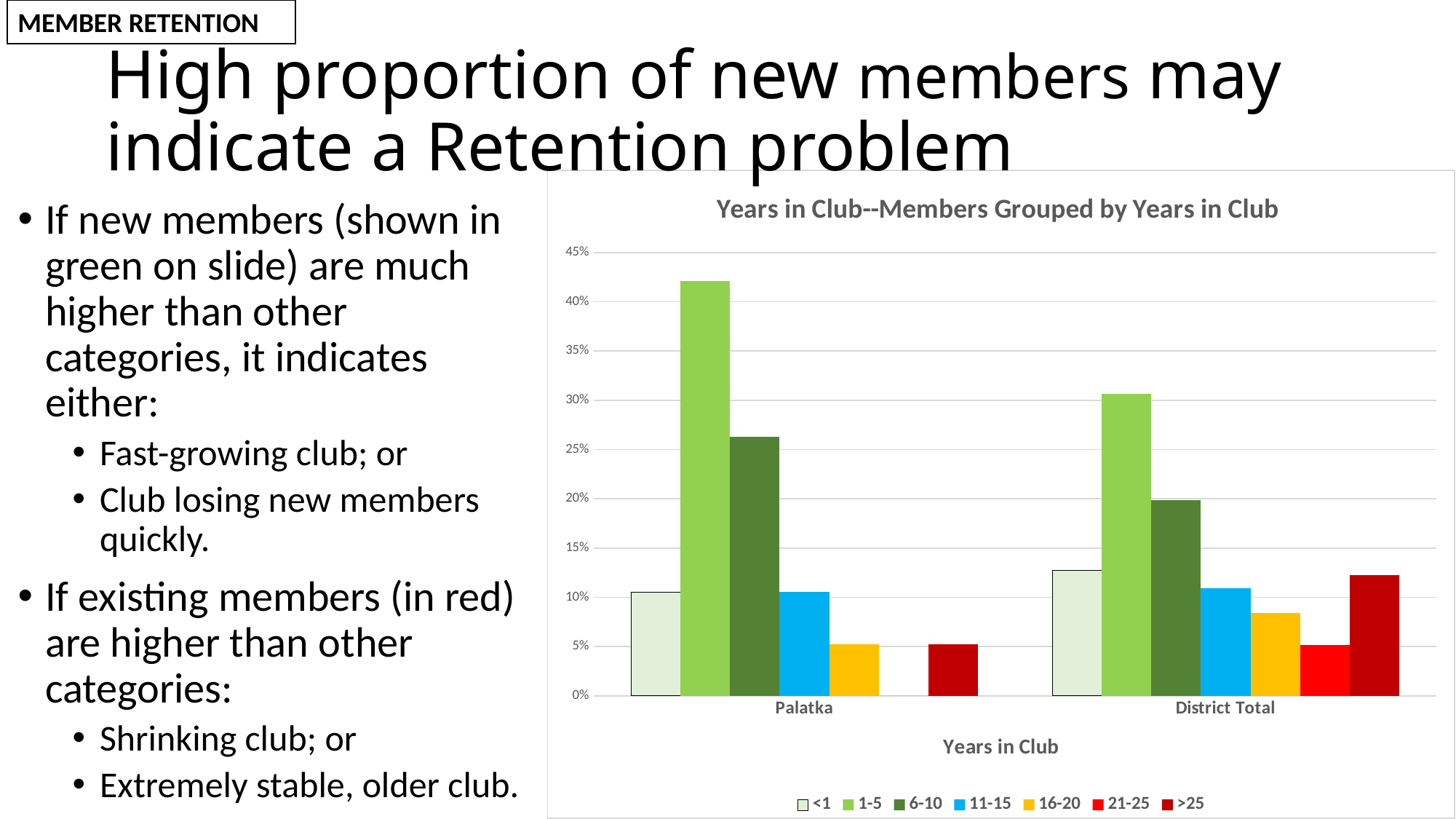
Is the value for the 1-5 group for Palatka greater or less than 40%? greater Is the value for the 16-20 group for Palatka greater or less than 10%? less How many categories are shown on the x axis of the chart? 2 What is the x-axis title of the chart? Years in Club Is the value for the 1-5 group for District Total greater or less than 35%? less What kind of chart is shown on the slide? bar chart How many series does the legend of the chart list? 7 What is the title of the chart? Years in Club--Members Grouped by Years in Club Which years-in-club group has the highest bar for District Total? 1-5 Is the 1-5 bar larger for Palatka or for District Total? Palatka Which years-in-club group has the highest bar for Palatka? 1-5